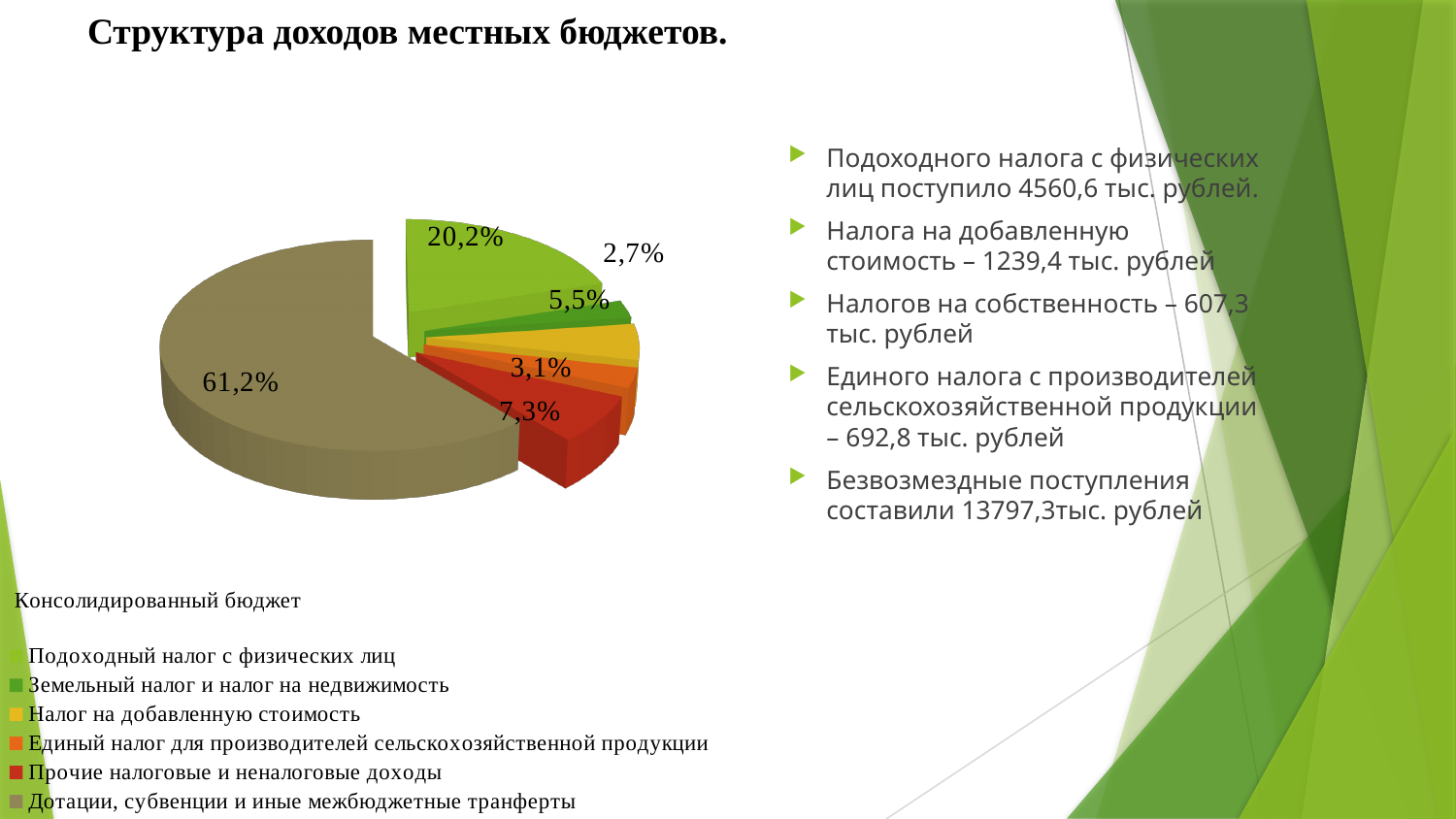
Which slice is larger: Прочие налоговые и неналоговые доходы or Налог на добавленную стоимость? Прочие налоговые и неналоговые доходы What share of the pie does the slice for Подоходный налог с физических лиц represent? 20,2% What title is printed below the pie chart? Консолидированный бюджет What kind of chart is shown on the slide? pie chart What share of the pie does the slice for Налог на добавленную стоимость represent? 5,5% Which category has the smallest slice of the pie? Земельный налог и налог на недвижимость What share of the pie does the slice for Земельный налог и налог на недвижимость represent? 2,7% Which category has the largest slice of the pie? Дотации, субвенции и иные межбюджетные трансферты How many slices does the pie chart have? 6 What is the difference in percentage points between the slice for Дотации, субвенции и иные межбюджетные трансферты and the slice for Подоходный налог с физических лиц? 41,0 percentage points